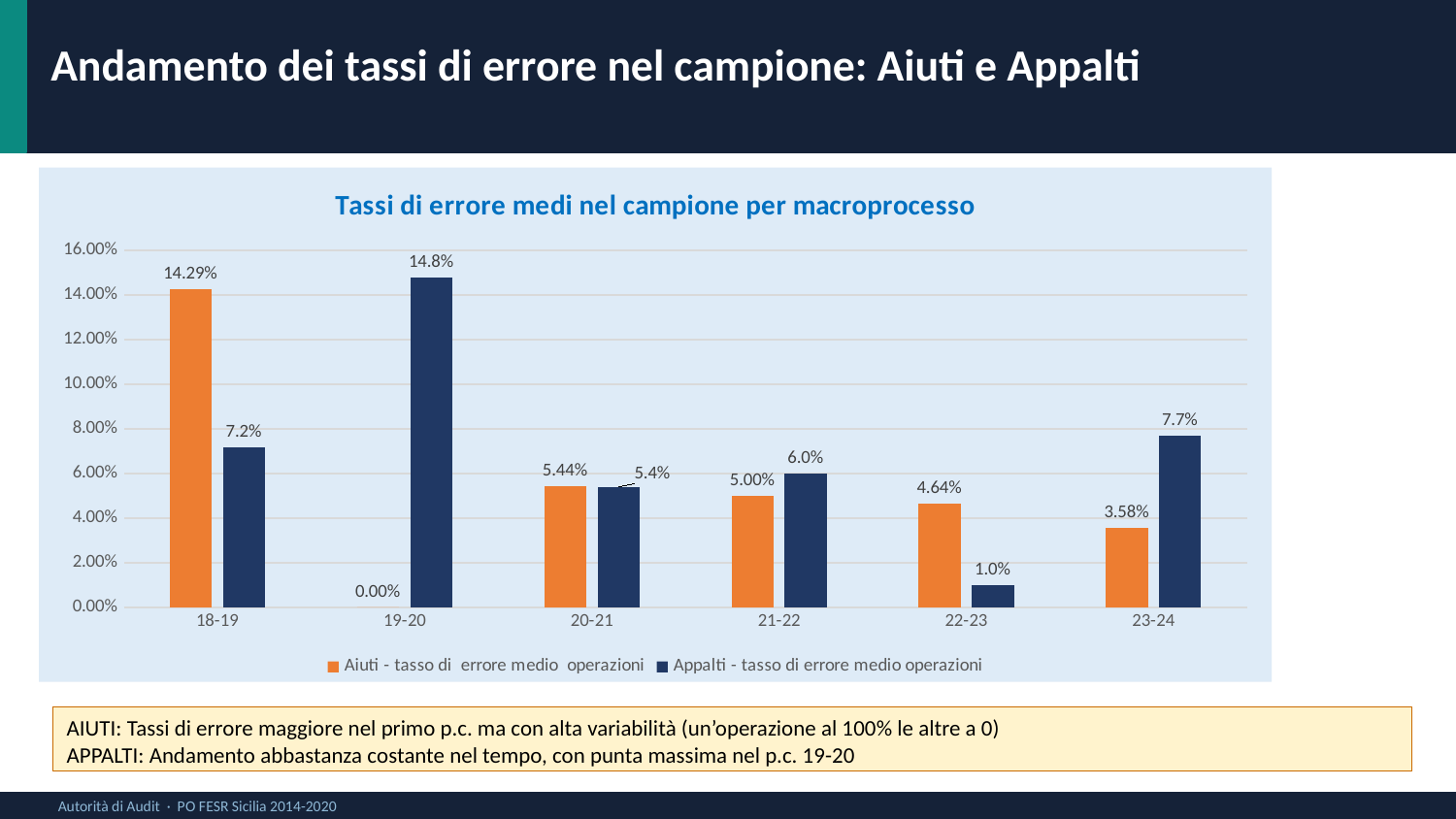
What is the Appalti error rate for 19-20? 14.8% What is the difference between the Appalti error rate in 19-20 and in 23-24? 7.1 percentage points In which period is the Aiuti error rate lowest? 19-20 What is the Aiuti error rate for 18-19? 14.29% Does the Aiuti error rate rise or fall from 20-21 to 23-24? fall In which period is the Appalti error rate highest? 19-20 Is the Appalti error rate for 18-19 greater or less than 8.00%? less How many periods are shown on the x axis? 6 What is the Appalti error rate for 22-23? 1.0% In 21-22, which series has the higher error rate, Aiuti or Appalti? Appalti How many series does the legend list? 2 What is the Aiuti error rate for 23-24? 3.58%